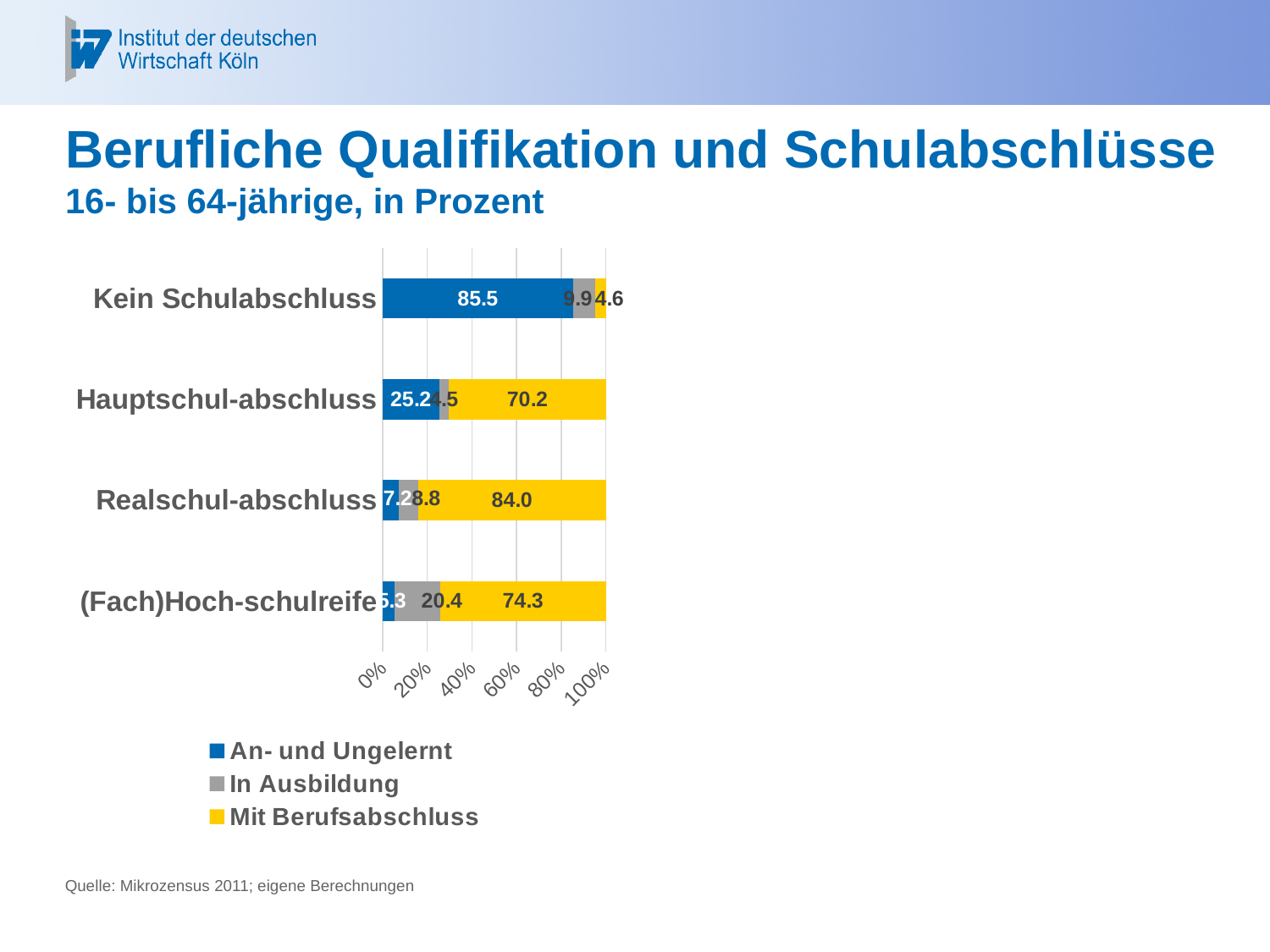
Which category has the highest value for An- und Ungelernt? Kein Schulabschluss What is the value for Mit Berufsabschluss in the Hauptschul-abschluss category? 70.2 What kind of chart is shown on the slide? Stacked bar chart Which legend entry is shown in yellow? Mit Berufsabschluss How many school-qualification categories are shown on the chart? 4 Which is larger: the Mit Berufsabschluss value for Realschul-abschluss or for (Fach)Hoch-schulreife? Realschul-abschluss How many series does the legend list? 3 What is the value for In Ausbildung in the (Fach)Hoch-schulreife category? 20.4 What is the difference between the Mit Berufsabschluss values for Realschul-abschluss (84.0) and Hauptschul-abschluss (70.2)? 13.8 What is the value for Mit Berufsabschluss in the Realschul-abschluss category? 84.0 What is the value for An- und Ungelernt in the Kein Schulabschluss category? 85.5 Which category has the lowest value for Mit Berufsabschluss? Kein Schulabschluss